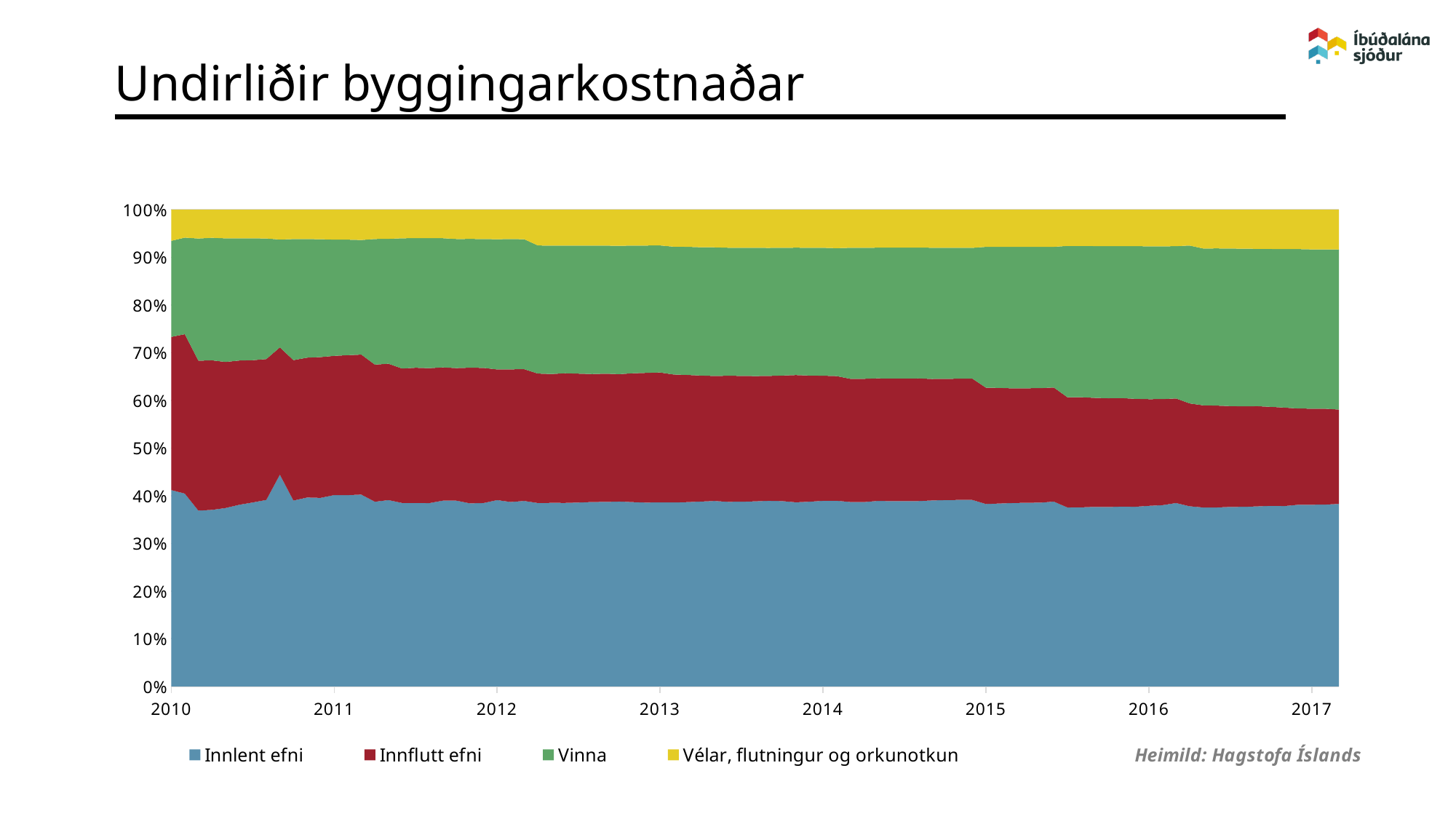
Which series has the smallest share in 2017? Vélar, flutningur og orkunotkun Does the share of Vinna rise or fall from 2010 to 2017? rise Is the share of Vélar, flutningur og orkunotkun in 2010 greater or less than 10%? less Which series has the largest share in 2017? Innlent efni How many series does the legend list? 4 Is the share of Innlent efni in 2013 greater or less than 50%? less How many years are labelled on the x axis? 8 In 2017, which is larger: the share of Innlent efni or the share of Innflutt efni? Innlent efni What is the title of the chart? Undirliðir byggingarkostnaðar What kind of chart is shown on the slide? Stacked area chart What source is cited below the chart? Hagstofa Íslands Does the share of Innflutt efni rise or fall from 2010 to 2017? fall